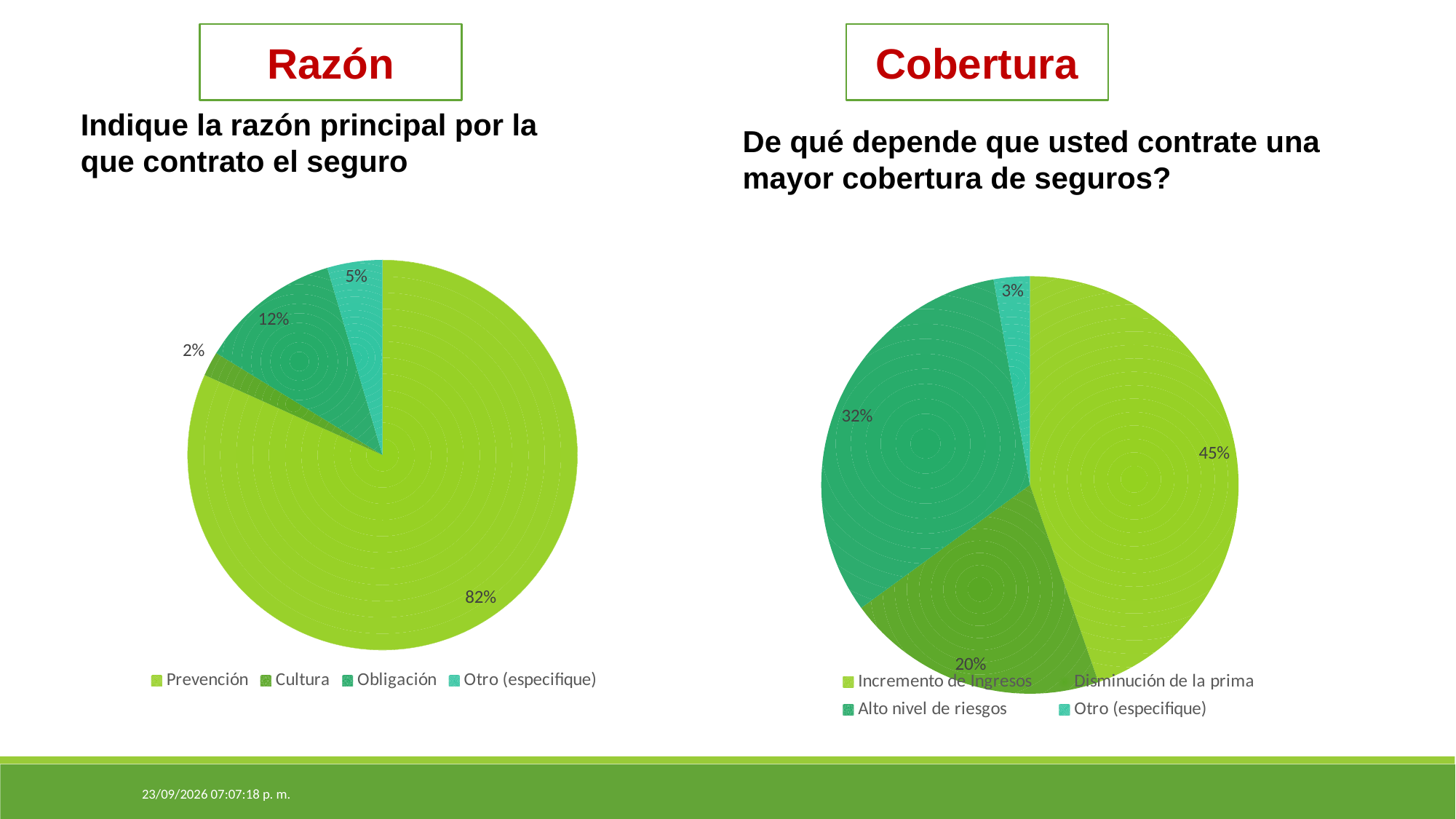
On the Razón chart, what share of respondents chose Prevención? 82% On the Cobertura chart, which is larger: Alto nivel de riesgos or Disminución de la prima? Alto nivel de riesgos What type of chart is used on the Cobertura side of the slide? Pie chart On the Razón chart, what is the difference between the Obligación and Otro (especifique) shares? 7% On the Cobertura chart, what percentage is shown for Alto nivel de riesgos? 32% On the Cobertura chart, what is the difference between Incremento de Ingresos and Alto nivel de riesgos? 13% On the Razón chart, what percentage corresponds to Obligación? 12% On the Cobertura chart, what share corresponds to Incremento de Ingresos? 45% On the Cobertura chart, which category has the smallest share? Otro (especifique) How many categories does the legend of the Razón chart list? 4 On the Razón chart, which category has the largest slice? Prevención On the Razón chart, which category has the smallest slice? Cultura